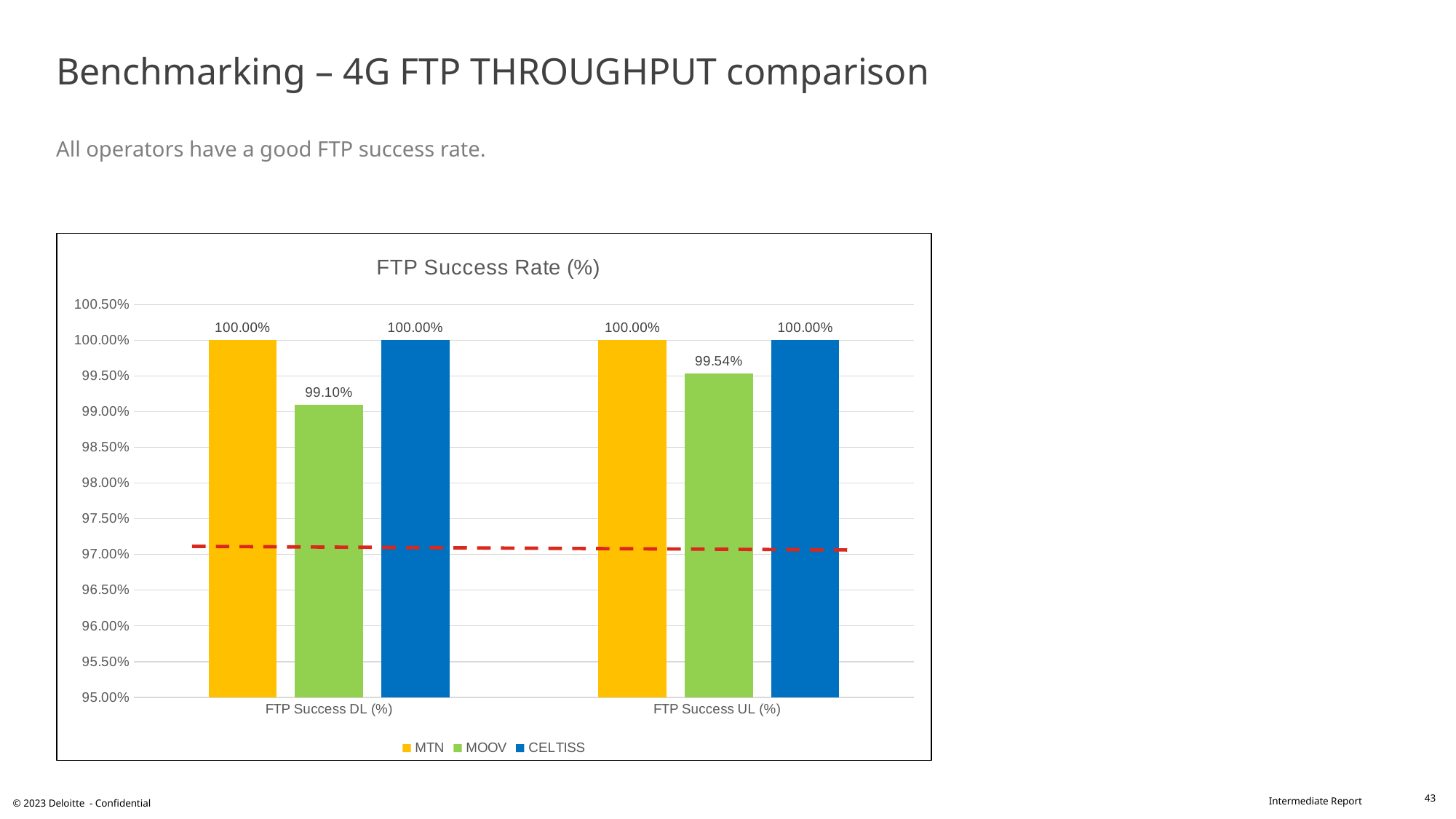
What type of chart is shown on the slide? Bar chart Which is larger for MOOV: FTP Success DL (%) or FTP Success UL (%)? FTP Success UL (%) Which operator has the lowest FTP Success DL (%)? MOOV How many series does the legend list? 3 What is the FTP Success DL (%) value for MTN? 100.00% What is the FTP Success UL (%) value for CELTISS? 100.00% Which operator has the lowest FTP Success UL (%)? MOOV What is the difference between MOOV's FTP Success UL (%) and FTP Success DL (%) values? 0.44% What is the FTP Success UL (%) value for MOOV? 99.54% What is the difference between MTN's and MOOV's FTP Success DL (%) values? 0.90% How many categories are shown on the x axis? 2 What is the FTP Success DL (%) value for MOOV? 99.10%